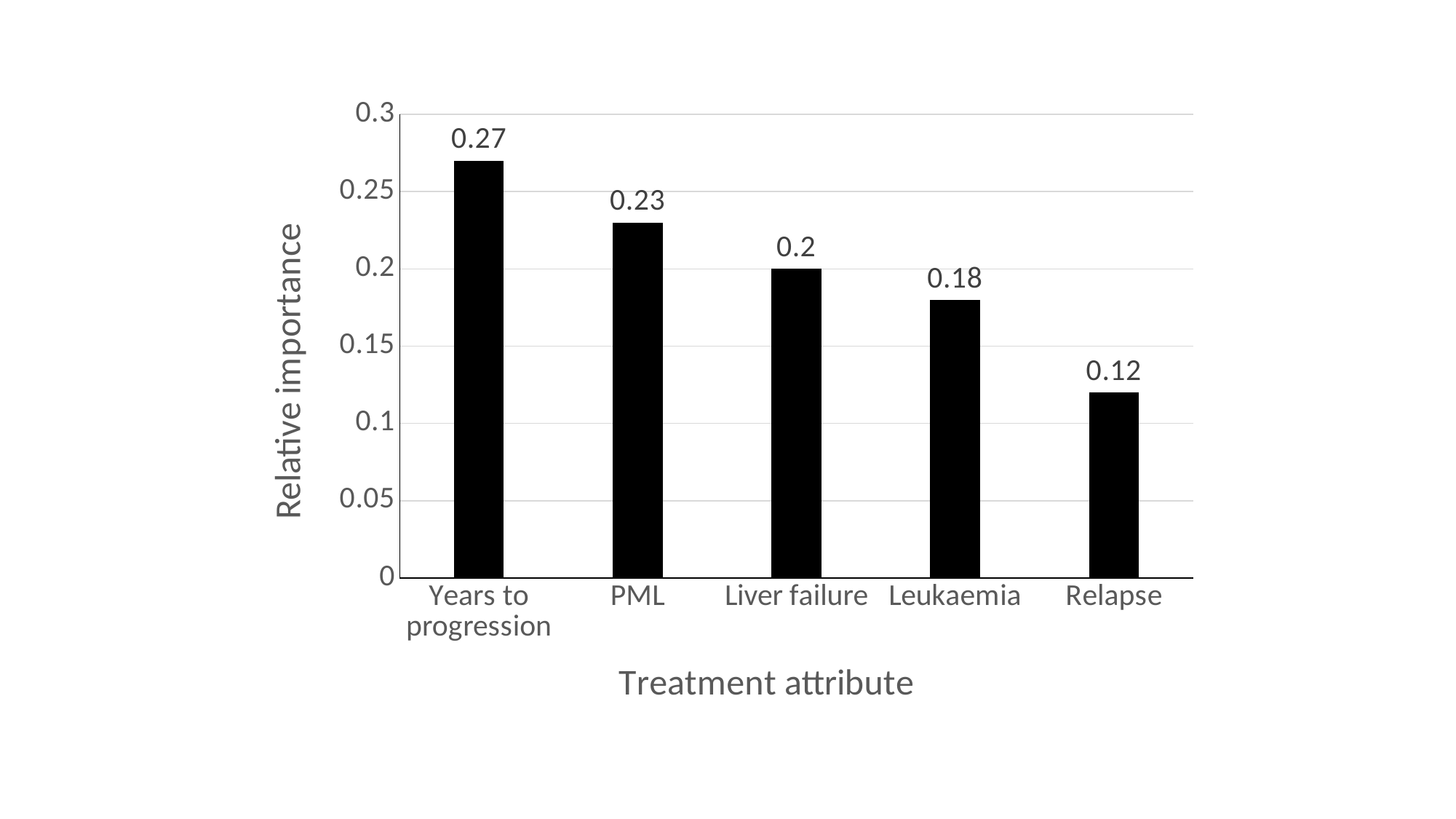
Which has a higher relative importance, Liver failure or Leukaemia? Liver failure Is the value for Leukaemia greater or less than 0.2? less Which treatment attribute has the lowest relative importance? Relapse What kind of chart is shown on the slide? Bar chart Do the values rise or fall from left to right along the x axis? Fall What is the difference in relative importance between PML and Leukaemia? 0.05 What is the relative importance value for Years to progression? 0.27 Which treatment attribute has the highest relative importance? Years to progression How many treatment attributes are shown on the x axis? 5 What is the difference in relative importance between Years to progression and Relapse? 0.15 What is the relative importance value for Relapse? 0.12 What is the relative importance value for PML? 0.23